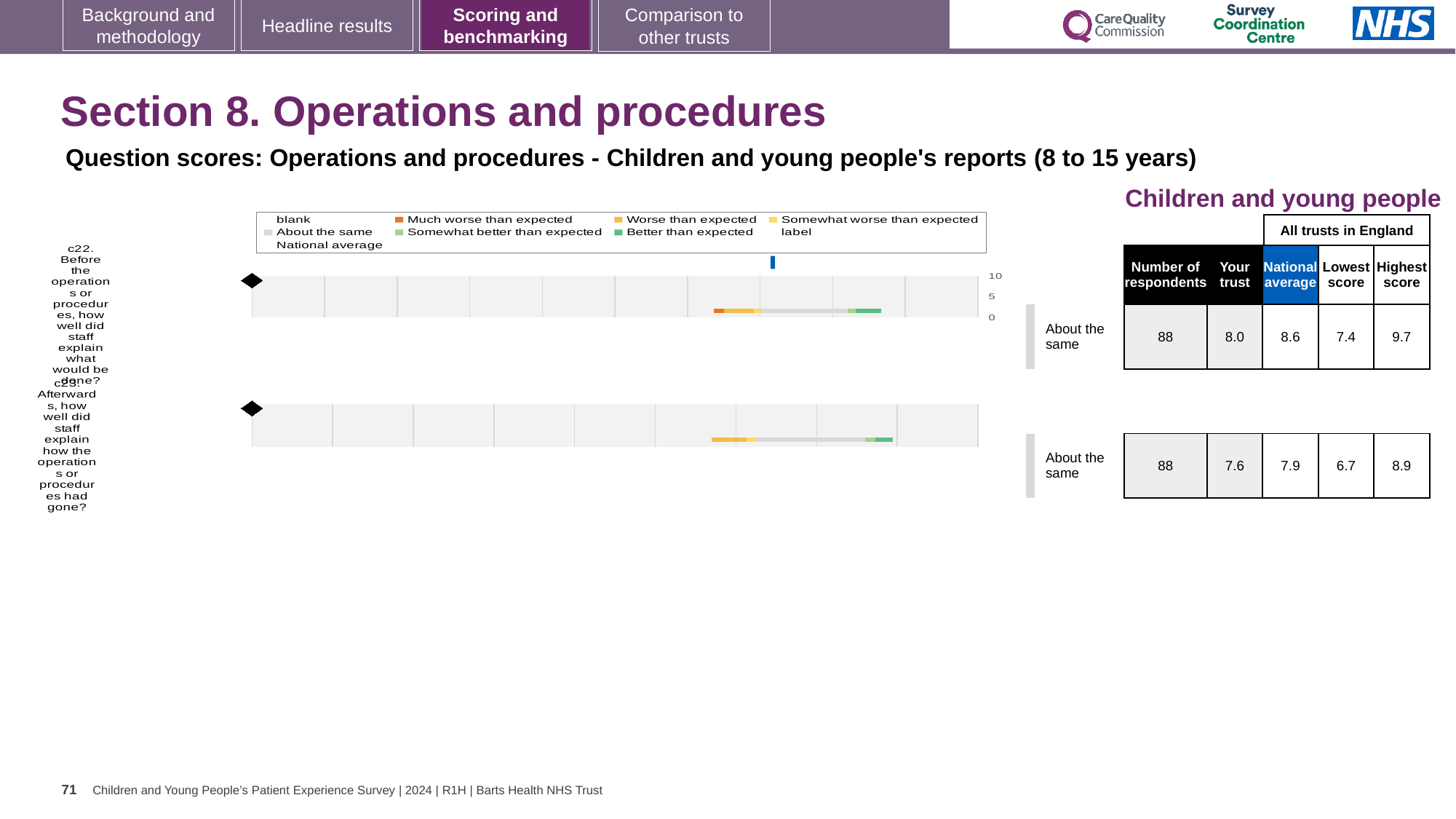
For question c22 (Before the operations or procedures, how well did staff explain what would be done?), what is the 'Your trust' score? 8.0 Which benchmark category is the trust placed in for both c22 and c23? About the same How many survey questions (rows) are plotted on the slide? 2 For question c23 (Afterwards, how well did staff explain how the operations or procedures had gone?), what is the 'Your trust' score? 7.6 For question c22, which is larger: the trust's score or the national average? National average For question c22, what is the national average score? 8.6 What colour represents 'Much worse than expected' in the legend? Orange How many respondents answered question c22? 88 For question c22, what is the difference between the highest score (9.7) and the lowest score (7.4) across all trusts? 2.3 For question c23, what is the highest score among all trusts in England? 8.9 What type of chart is used to show the question scores for c22 and c23? bar chart How many entries does the legend above the charts list? 9